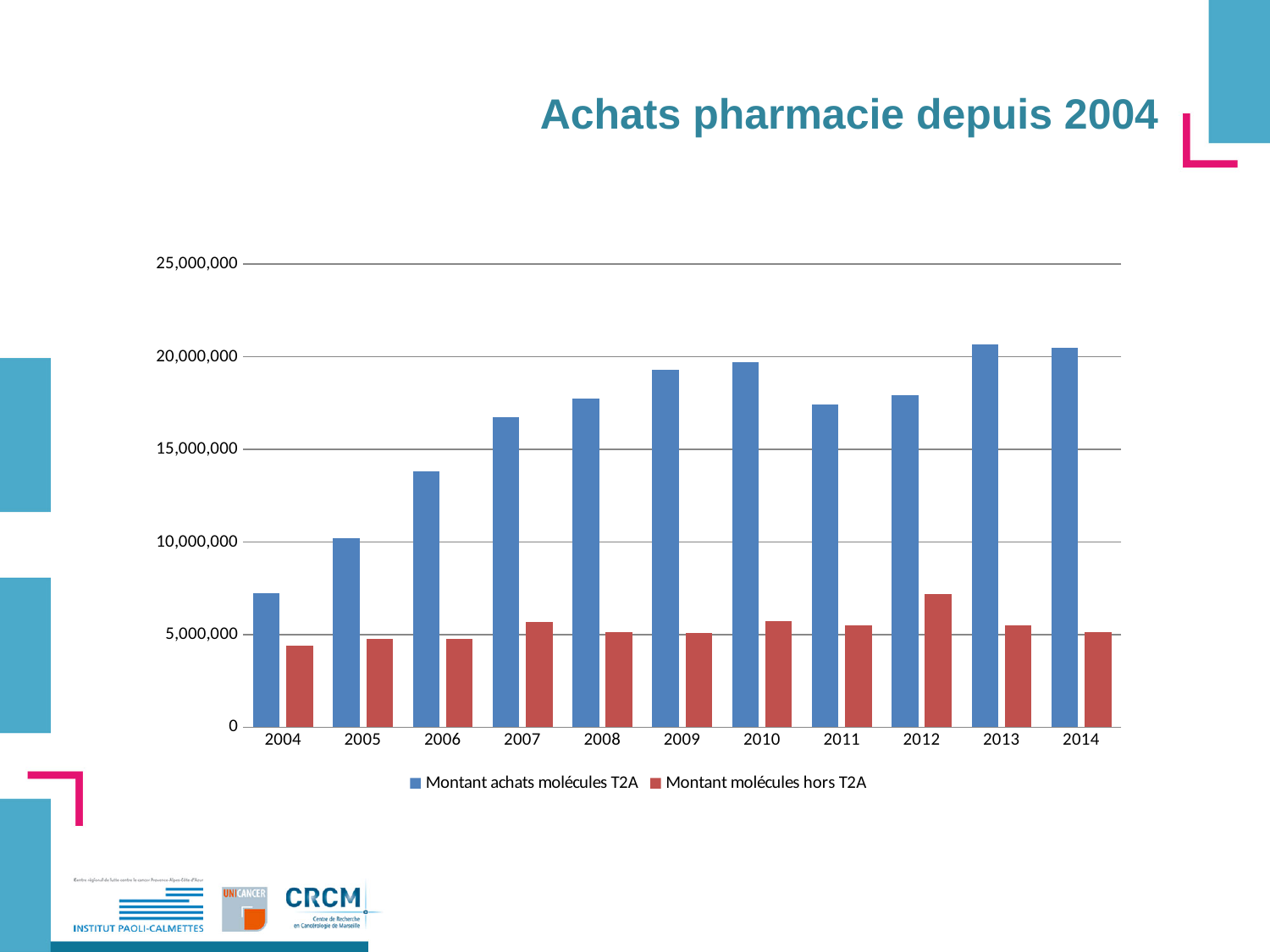
Which year has the lowest value for Montant molécules hors T2A? 2004 Is the value for Montant molécules hors T2A in 2012 greater or less than 5,000,000? greater Which year has the lowest value for Montant achats molécules T2A? 2004 Which is larger, Montant achats molécules T2A in 2010 or in 2011? 2010 Do the values for Montant achats molécules T2A generally rise or fall from 2004 to 2014? rise How many years are shown on the x axis? 11 What is the title of the chart? Achats pharmacie depuis 2004 Is the value for Montant achats molécules T2A in 2013 greater or less than 20,000,000? greater Which year has the highest value for Montant molécules hors T2A? 2012 Is the value for Montant achats molécules T2A in 2004 greater or less than 10,000,000? less How many series does the legend list? 2 What kind of chart is shown on the slide? bar chart